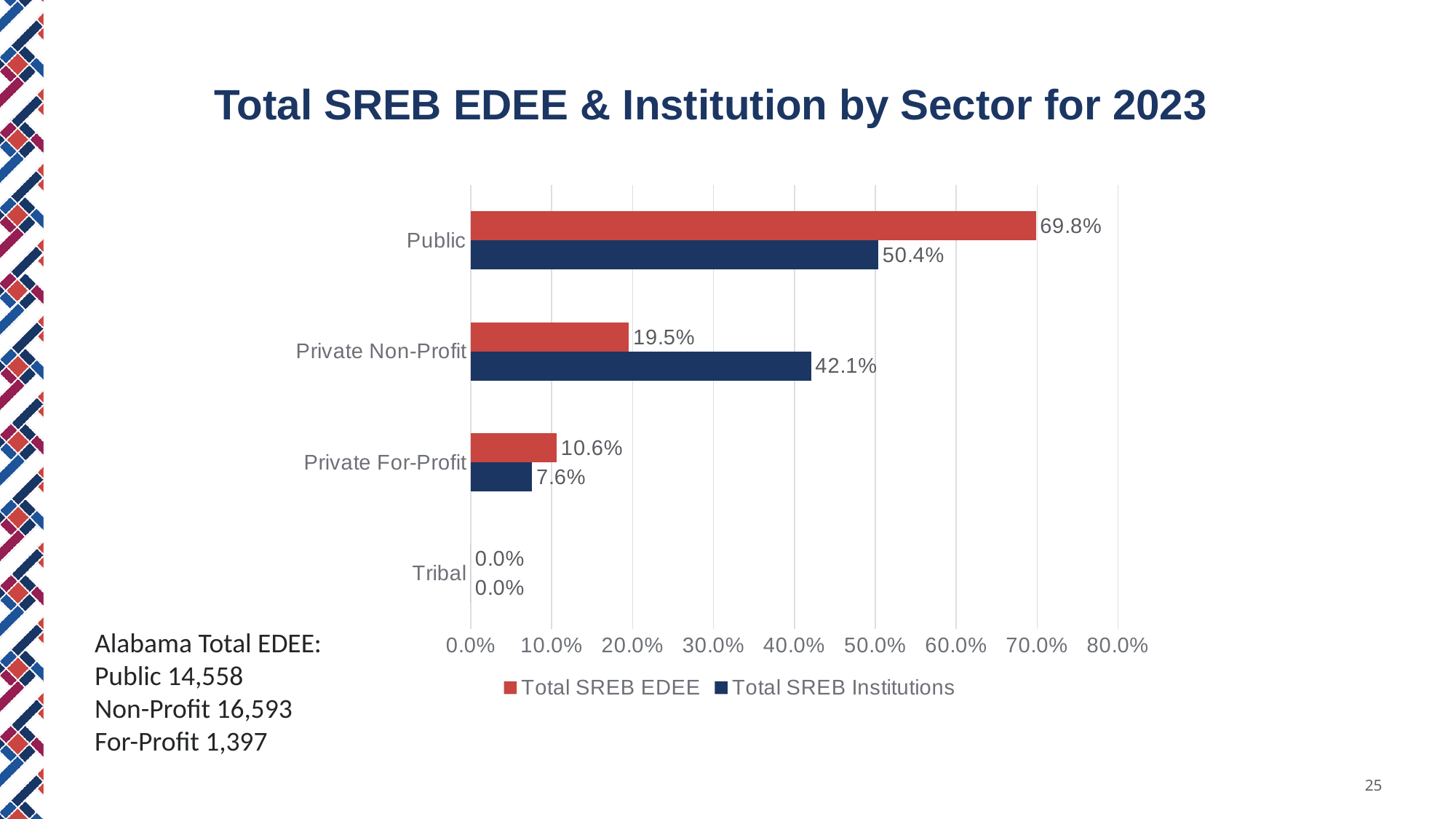
For Private Non-Profit, which is larger: Total SREB EDEE or Total SREB Institutions? Total SREB Institutions Which sector has the highest Total SREB EDEE value? Public How many series does the legend list? 2 How many sectors are shown on the chart? 4 What is the title of the chart? Total SREB EDEE & Institution by Sector for 2023 What is the difference between the Total SREB EDEE and Total SREB Institutions values for Public? 19.4% What is the Total SREB EDEE value for Private For-Profit? 10.6% What is the Total SREB Institutions value for Tribal? 0.0% Which sector has the lowest Total SREB Institutions value? Tribal What is the Total SREB Institutions value for Private Non-Profit? 42.1% What kind of chart is shown on the slide? Bar chart What is the Total SREB EDEE value for Public? 69.8%